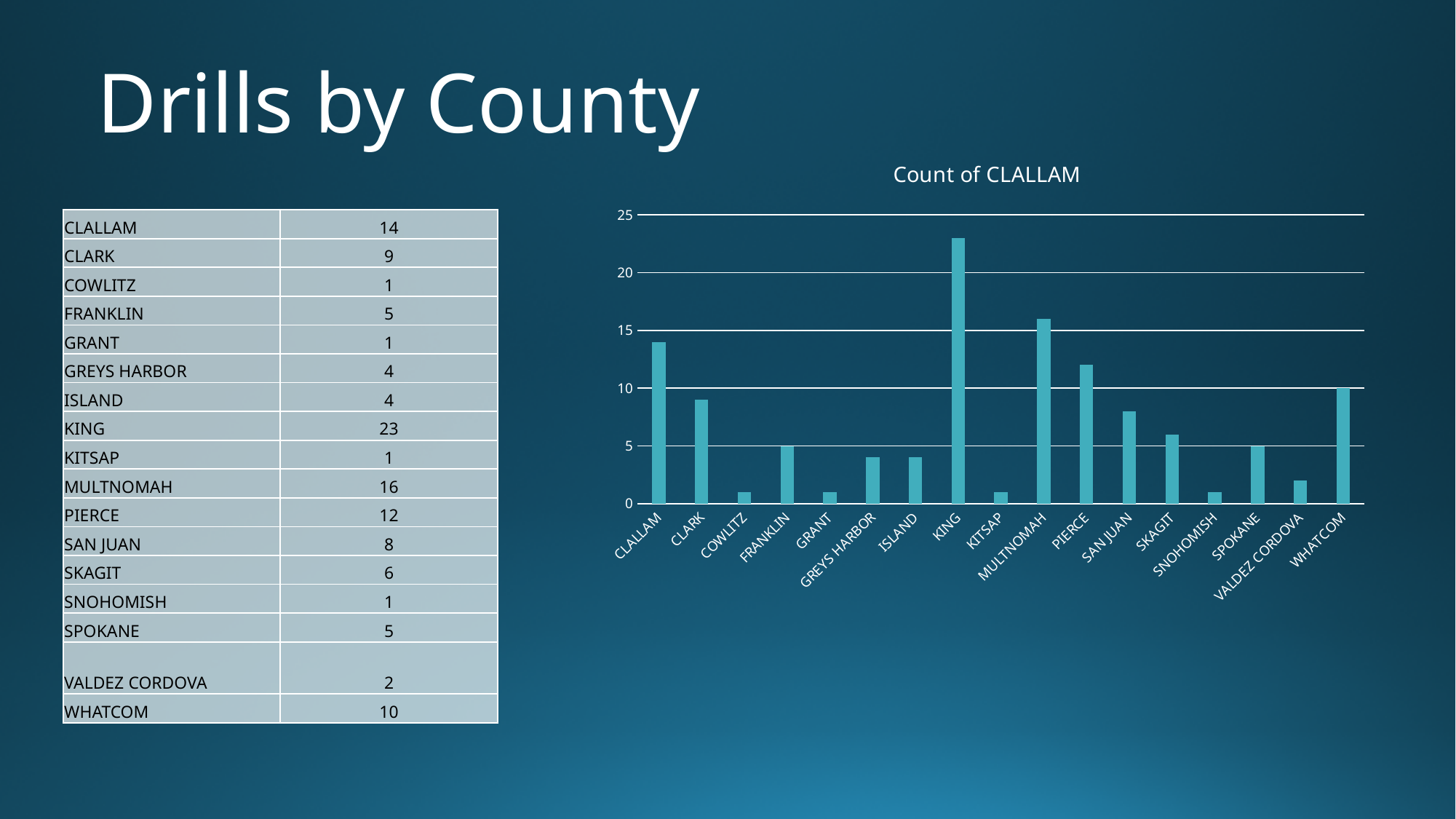
What is the value for WHATCOM? 10 What type of chart is shown on the slide? bar chart What is the difference between the values for KING and MULTNOMAH? 7 Is the value for SKAGIT greater or less than 10? less Which county has the highest value in the chart? KING What is the value for MULTNOMAH? 16 What is the difference between the values for PIERCE and SAN JUAN? 4 How many counties are shown on the x axis of the chart? 17 What is the value for KING? 23 Which is larger, the value for PIERCE or the value for CLARK? PIERCE What is the title of the chart? Count of CLALLAM Is the value for CLALLAM greater or less than 10? greater